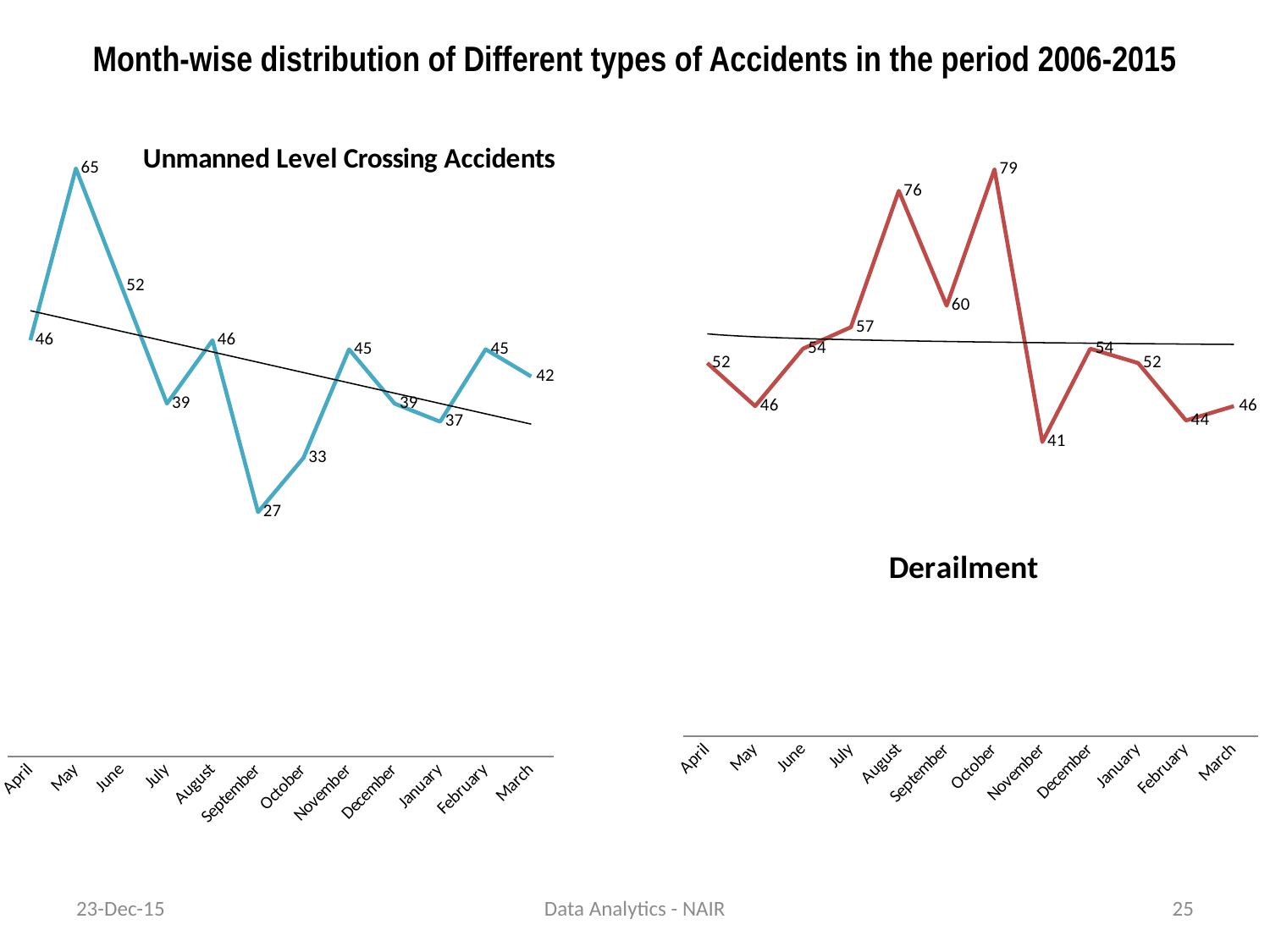
In the Unmanned Level Crossing Accidents chart, what is the value for May? 65 In the Derailment chart, what is the difference between the values for October and November? 38 In the Derailment chart, which is larger, the value for July or the value for February? July How many months are plotted in the Unmanned Level Crossing Accidents chart? 12 In the Derailment chart, which month has the lowest value? November In the Derailment chart, what is the value for March? 46 In the Derailment chart, which month has the highest value? October In the Unmanned Level Crossing Accidents chart, what is the difference between the values for May and September? 38 In the Unmanned Level Crossing Accidents chart, which month has the lowest value? September In the Unmanned Level Crossing Accidents chart, what is the value for January? 37 What type of chart is the Derailment chart? Line chart In the Derailment chart, what is the value for August? 76